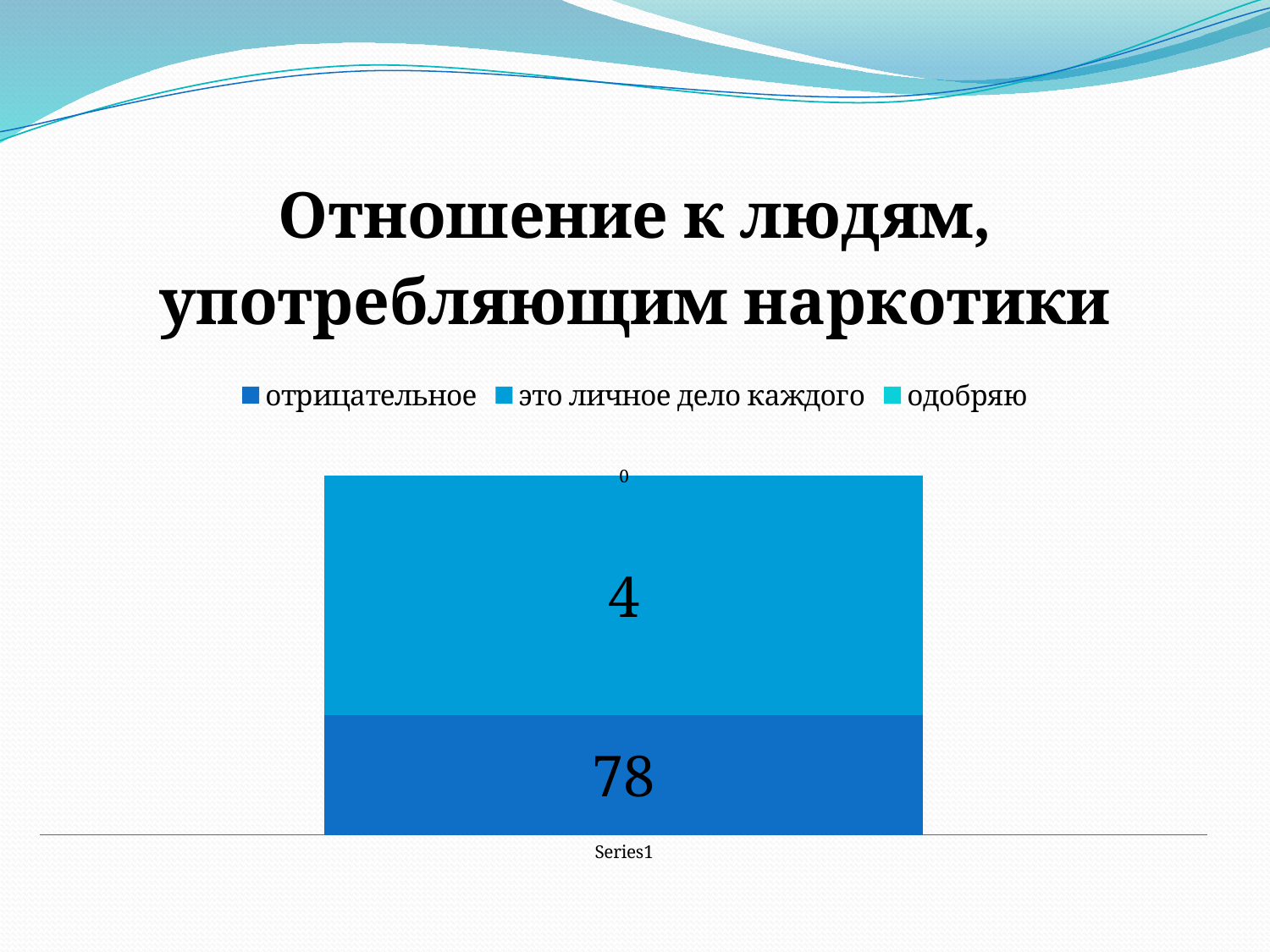
Which is larger, the value for "отрицательное" or the value for "это личное дело каждого"? отрицательное What is the value for "это личное дело каждого"? 4 What is the total of the stacked bar for Series1? 82 What is the value for "одобряю"? 0 What is the difference between the values for "отрицательное" and "это личное дело каждого"? 74 Which series has the lowest value? одобряю Which series has the highest value? отрицательное How many series does the legend list? 3 What is the value for "отрицательное"? 78 How many categories are shown on the x axis? 1 What is the title of the chart? Отношение к людям, употребляющим наркотики What kind of chart is shown on the slide? stacked bar chart